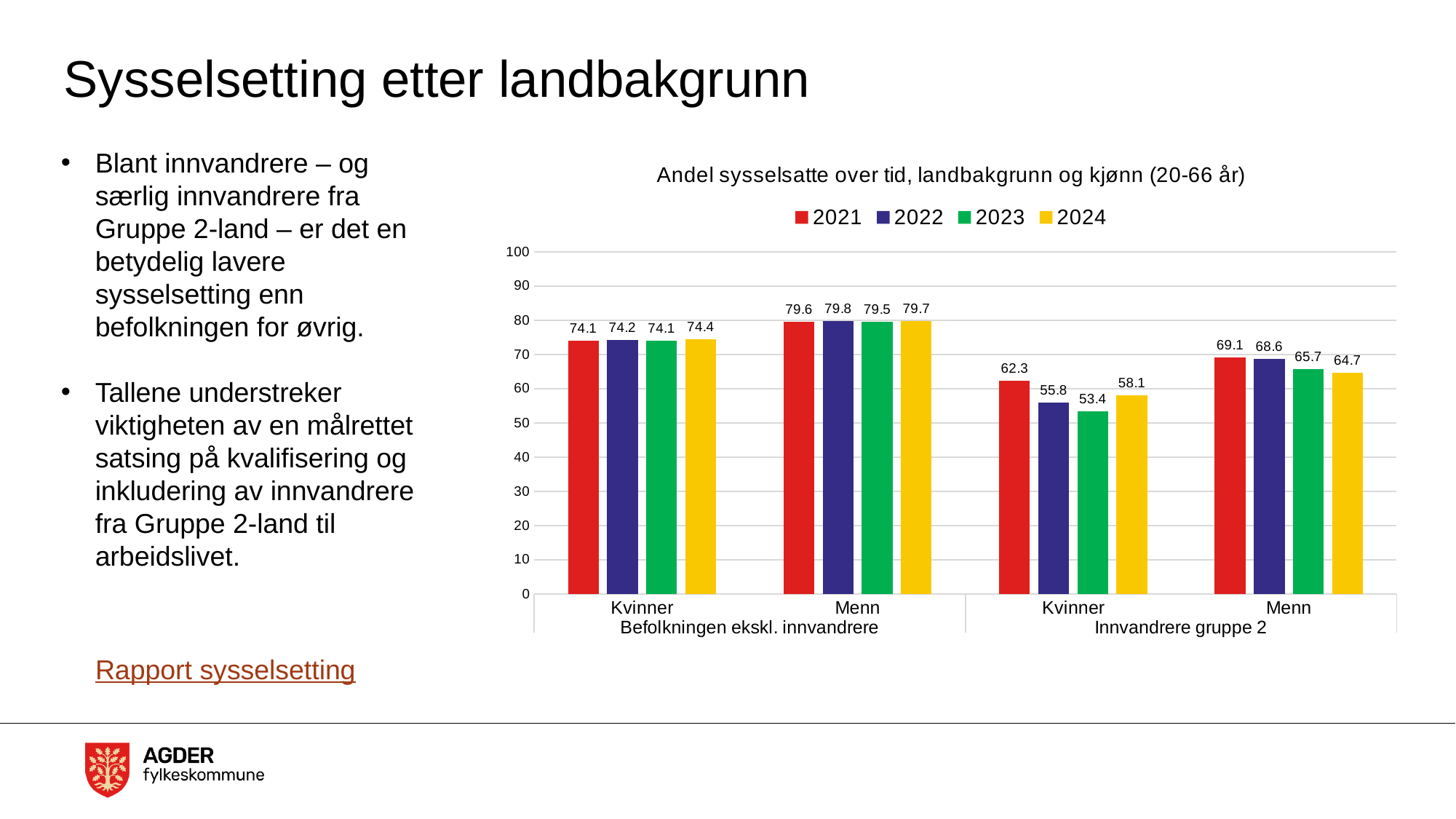
What is the difference between the 2024 values for Menn and Kvinner in the Innvandrere gruppe 2 group? 6.6 Which year has the lowest value for Kvinner in the Innvandrere gruppe 2 group? 2023 How many series does the legend list? 4 What is the difference between the 2021 and 2023 values for Kvinner in the Innvandrere gruppe 2 group? 8.9 Which is larger: the 2022 value for Kvinner in Befolkningen ekskl. innvandrere or the 2022 value for Menn in Innvandrere gruppe 2? Kvinner in Befolkningen ekskl. innvandrere What is the 2024 value for Kvinner in the Innvandrere gruppe 2 group? 58.1 What kind of chart is shown on the slide? Bar chart What is the title of the chart? Andel sysselsatte over tid, landbakgrunn og kjønn (20-66 år) Which year has the highest value for Menn in the Innvandrere gruppe 2 group? 2021 What is the 2023 value for Menn in the Innvandrere gruppe 2 group? 65.7 Do the values for Menn in the Innvandrere gruppe 2 group rise or fall from 2021 to 2024? Fall What is the 2021 value for Menn in the Befolkningen ekskl. innvandrere group? 79.6